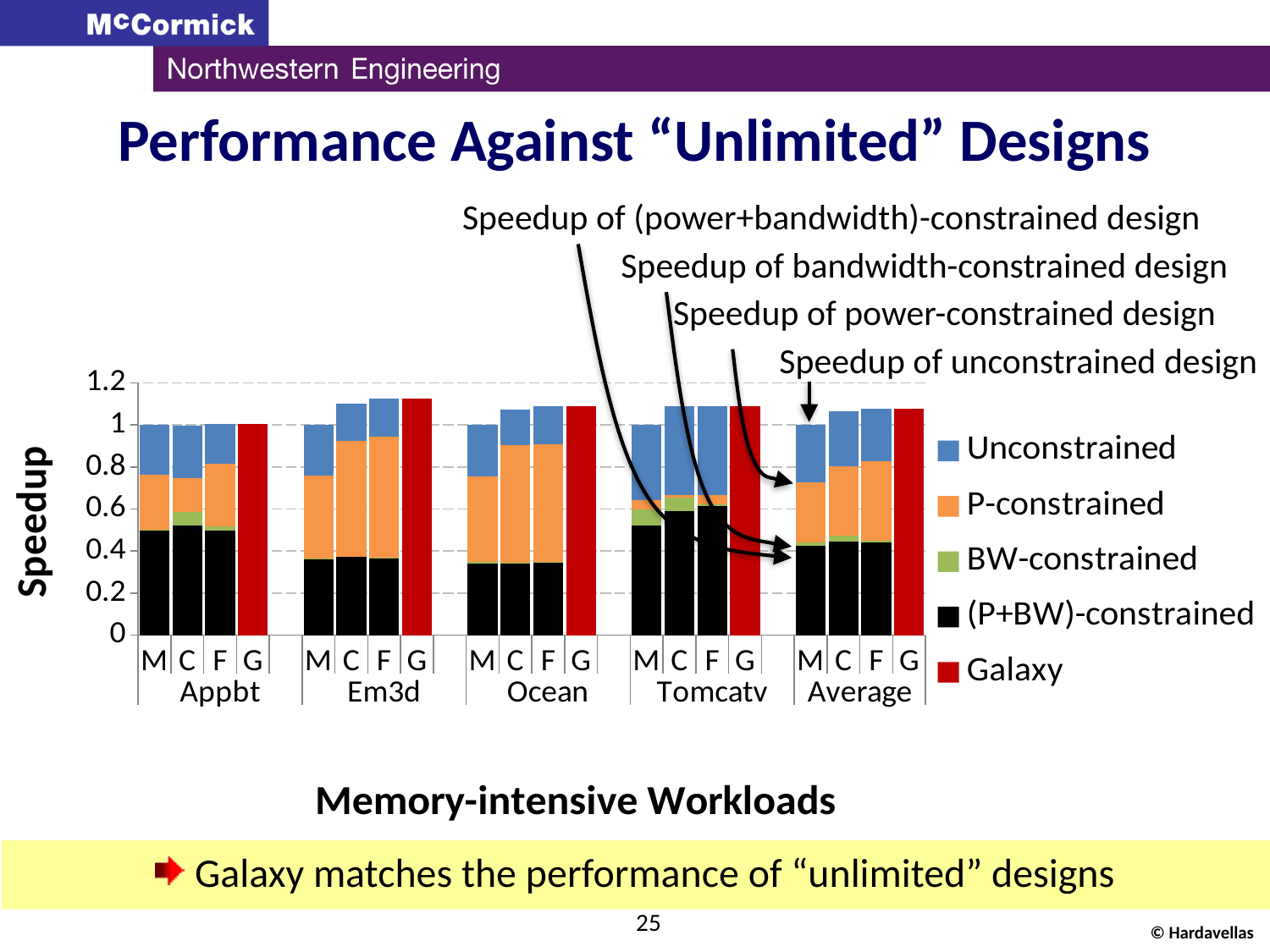
What colour represents Galaxy in the legend? Red Is the Galaxy (G) bar for Average greater or less than 1? greater Which is taller, the Galaxy (G) bar for Em3d or the Galaxy (G) bar for Appbt? Em3d Is the Galaxy (G) bar for Em3d greater or less than 1? greater What kind of chart is shown on the slide? Stacked bar chart Is the (P+BW)-constrained segment of the M bar for Em3d greater or less than 0.4? less How many workload groups are shown along the x axis? 5 What is the speedup of the Galaxy (G) bar for Appbt? 1 How many series does the legend list? 5 What is the total speedup of the M bar for Appbt? 1 What is the label of the y axis? Speedup